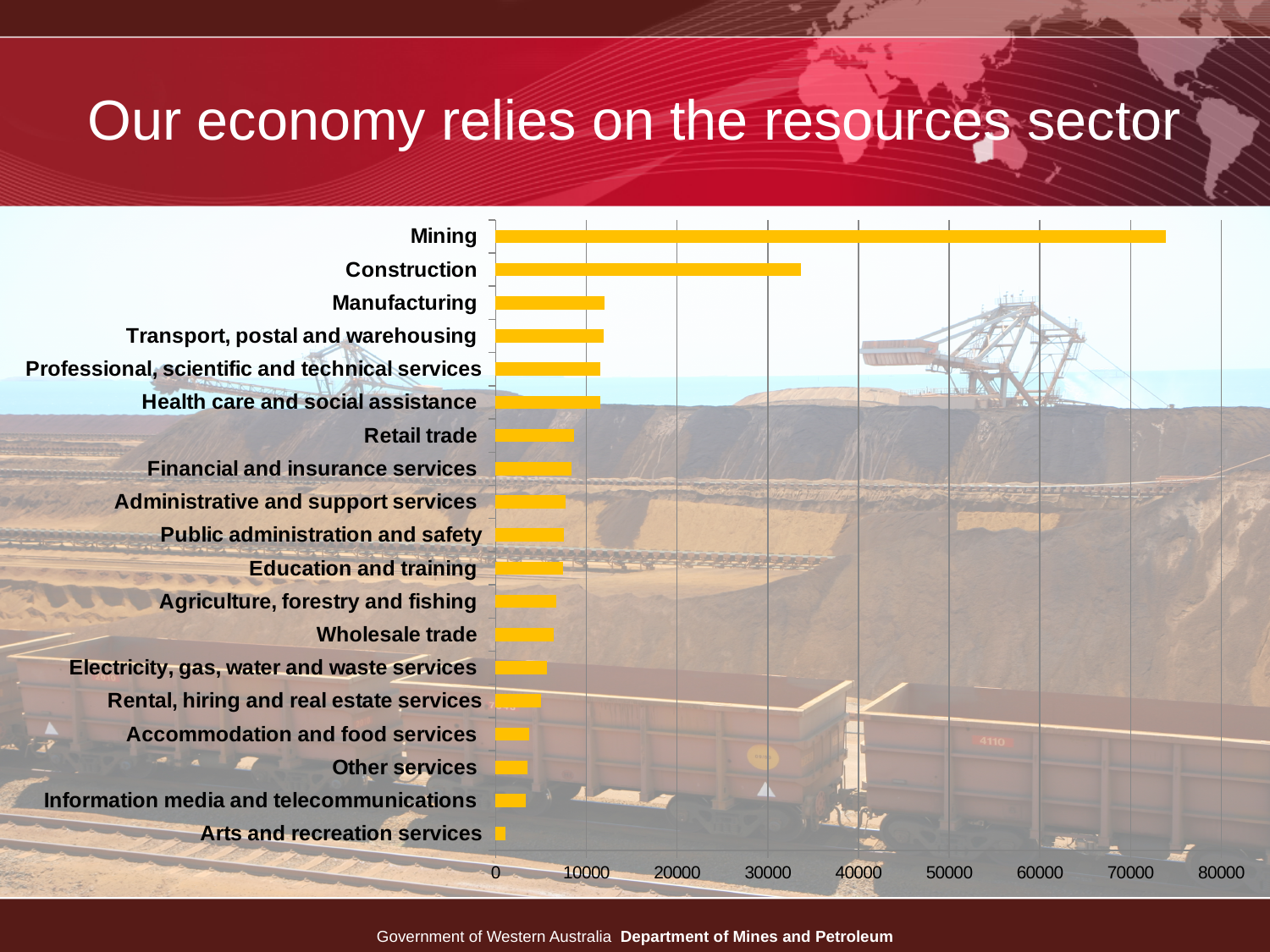
Which category has the lowest value in the chart? Arts and recreation services Which category has the highest value in the chart? Mining Is the value for Construction greater or less than 30000? greater Is the value for Mining greater or less than 70000? greater What is the title of the slide containing the chart? Our economy relies on the resources sector How many industry categories are plotted in the chart? 19 What kind of chart is shown on the slide? Bar chart Is the value for Arts and recreation services greater or less than 10000? less Which has the larger value, Construction or Manufacturing? Construction Which has the larger value, Retail trade or Arts and recreation services? Retail trade Which has the larger value, Mining or Construction? Mining